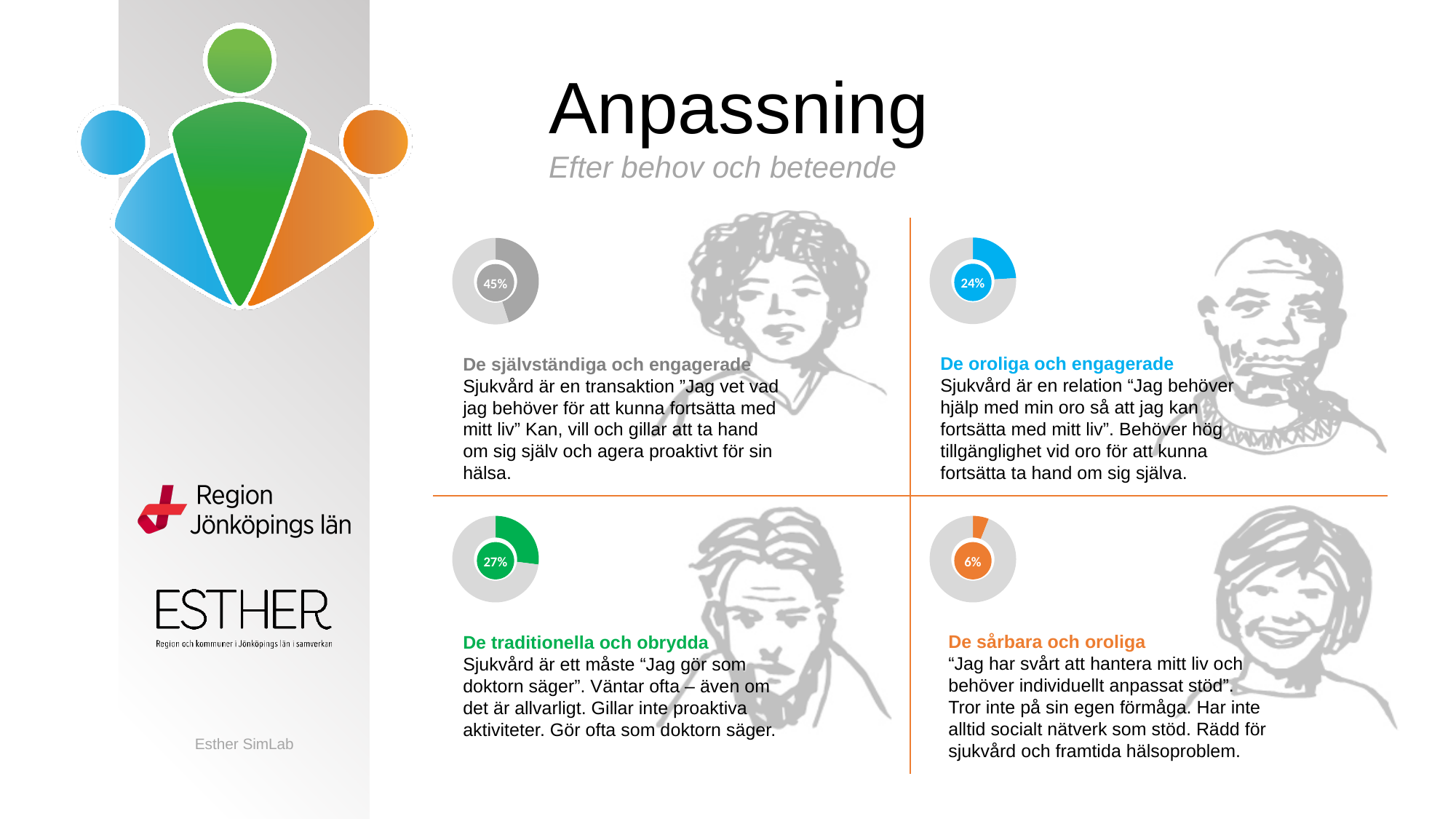
What colour is the filled segment of the donut chart for "De sårbara och oroliga"? Orange What percentage is shown in the donut chart for "De självständiga och engagerade"? 45% Which of the four groups has the lowest percentage? De sårbara och oroliga What percentage is shown in the donut chart for "De sårbara och oroliga"? 6% What kind of chart is used to show each group's percentage? Donut (pie) chart How many donut charts are on the slide? 4 What is the difference in percentage points between "De oroliga och engagerade" and "De sårbara och oroliga"? 18 What percentage is shown in the donut chart for "De oroliga och engagerade"? 24% What percentage is shown in the donut chart for "De traditionella och obrydda"? 27% Which of the four groups has the highest percentage? De självständiga och engagerade What is the difference in percentage points between "De självständiga och engagerade" and "De traditionella och obrydda"? 18 Which has a larger percentage, "De traditionella och obrydda" or "De oroliga och engagerade"? De traditionella och obrydda